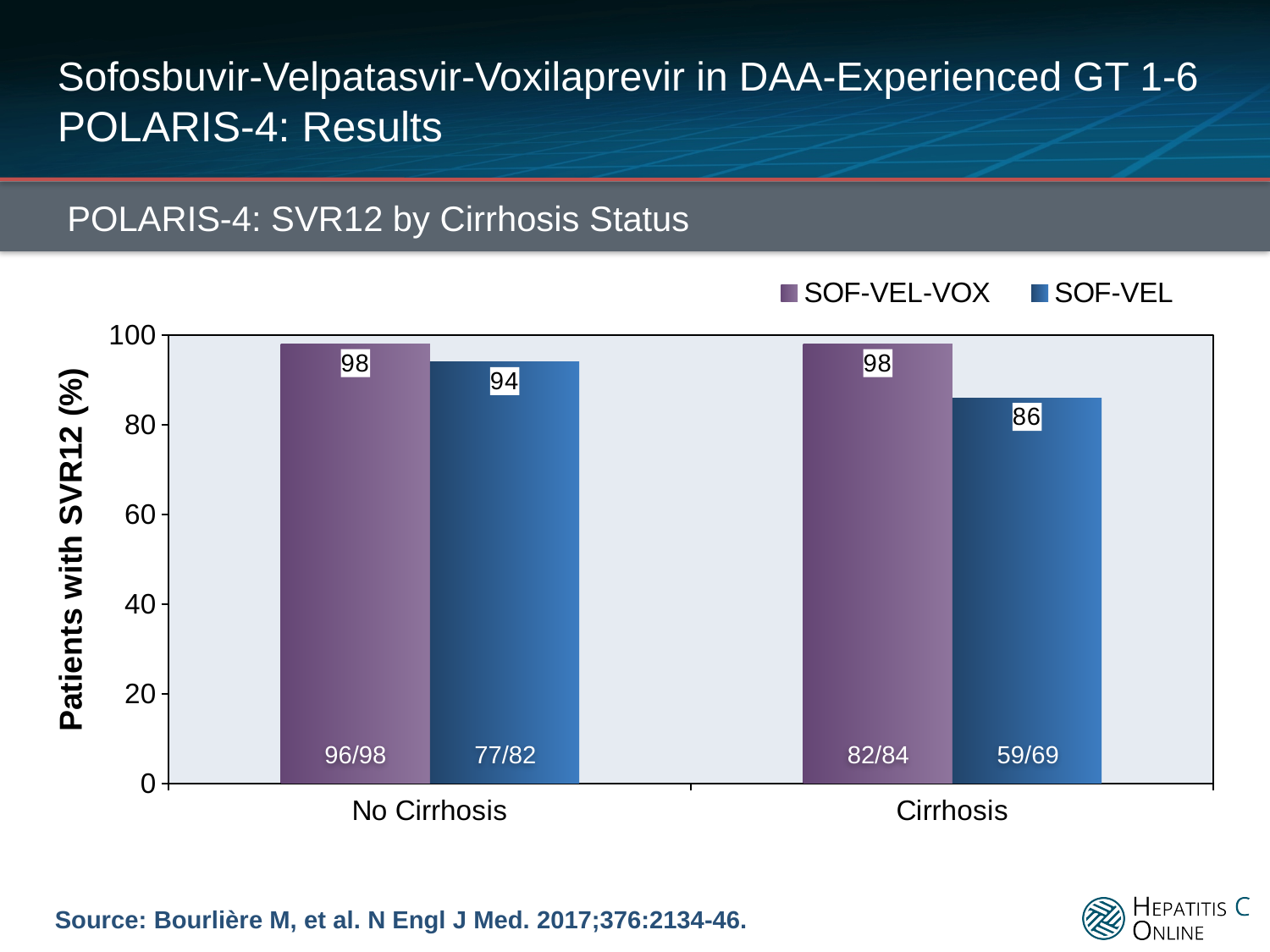
What is the SVR12 rate for SOF-VEL-VOX in the No Cirrhosis group? 98 Which has a higher SVR12 rate in the Cirrhosis group, SOF-VEL-VOX or SOF-VEL? SOF-VEL-VOX What is the SVR12 rate for SOF-VEL in the No Cirrhosis group? 94 How many series does the legend list? 2 What is the SVR12 rate for SOF-VEL in the Cirrhosis group? 86 What is the difference in SVR12 rate between SOF-VEL-VOX and SOF-VEL in the No Cirrhosis group? 4 What is the label of the y axis? Patients with SVR12 (%) Which bar has the lowest SVR12 rate on the chart? SOF-VEL, Cirrhosis What kind of chart is shown on the slide? Bar chart How many categories are shown on the x axis? 2 What is the difference in SVR12 rate between SOF-VEL-VOX and SOF-VEL in the Cirrhosis group? 12 What fraction of patients is shown for SOF-VEL in the Cirrhosis group? 59/69